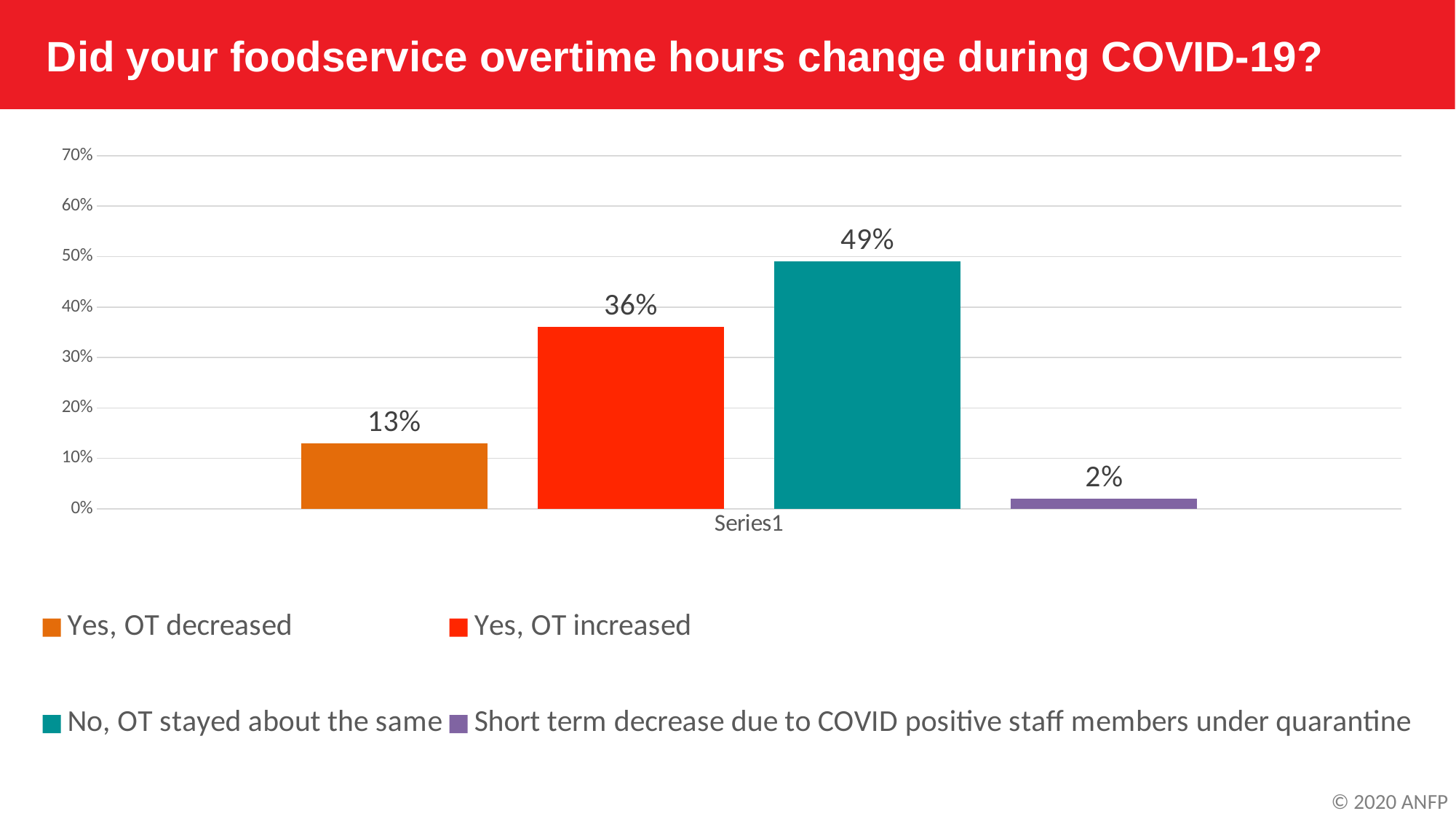
What percentage of respondents reported a short term decrease due to COVID positive staff members under quarantine? 2% Which is larger: the percentage for 'Yes, OT decreased' or 'Yes, OT increased'? Yes, OT increased What percentage of respondents said their OT decreased? 13% What percentage of respondents said their OT increased? 36% What percentage of respondents said OT stayed about the same? 49% What type of chart is shown on the slide? Bar chart Which response has the lowest percentage? Short term decrease due to COVID positive staff members under quarantine What is the title of the slide? Did your foodservice overtime hours change during COVID-19? What colour is the bar for 'No, OT stayed about the same'? Teal How many response categories are shown in the chart? 4 What is the difference in percentage points between 'No, OT stayed about the same' and 'Yes, OT increased'? 13 percentage points Which response has the highest percentage? No, OT stayed about the same